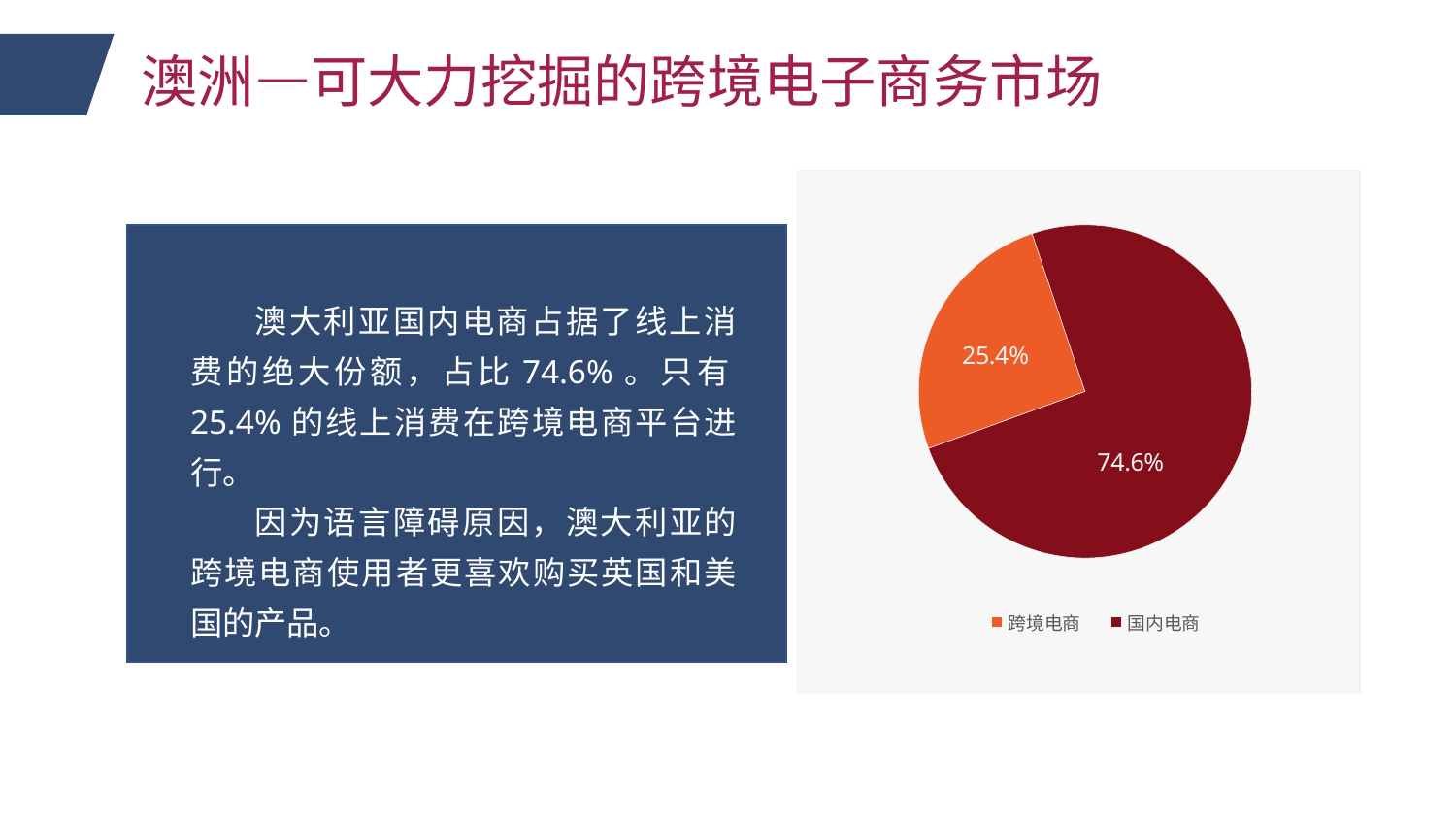
What is the difference between the 国内电商 and 跨境电商 values in the pie chart? 49.2% Which category has the smallest slice in the pie chart? 跨境电商 How many entries does the legend of the pie chart list? 2 What is the value shown for 国内电商 in the pie chart? 74.6% Which is larger in the pie chart, 跨境电商 or 国内电商? 国内电商 How many slices does the pie chart have? 2 What is the value shown for 跨境电商 in the pie chart? 25.4% Where is the legend positioned in the pie chart? below the pie Which category has the largest slice in the pie chart? 国内电商 What colour is the 跨境电商 slice in the pie chart? orange What kind of chart is shown on the slide? pie chart What share of the pie does the 跨境电商 slice represent? 25.4%